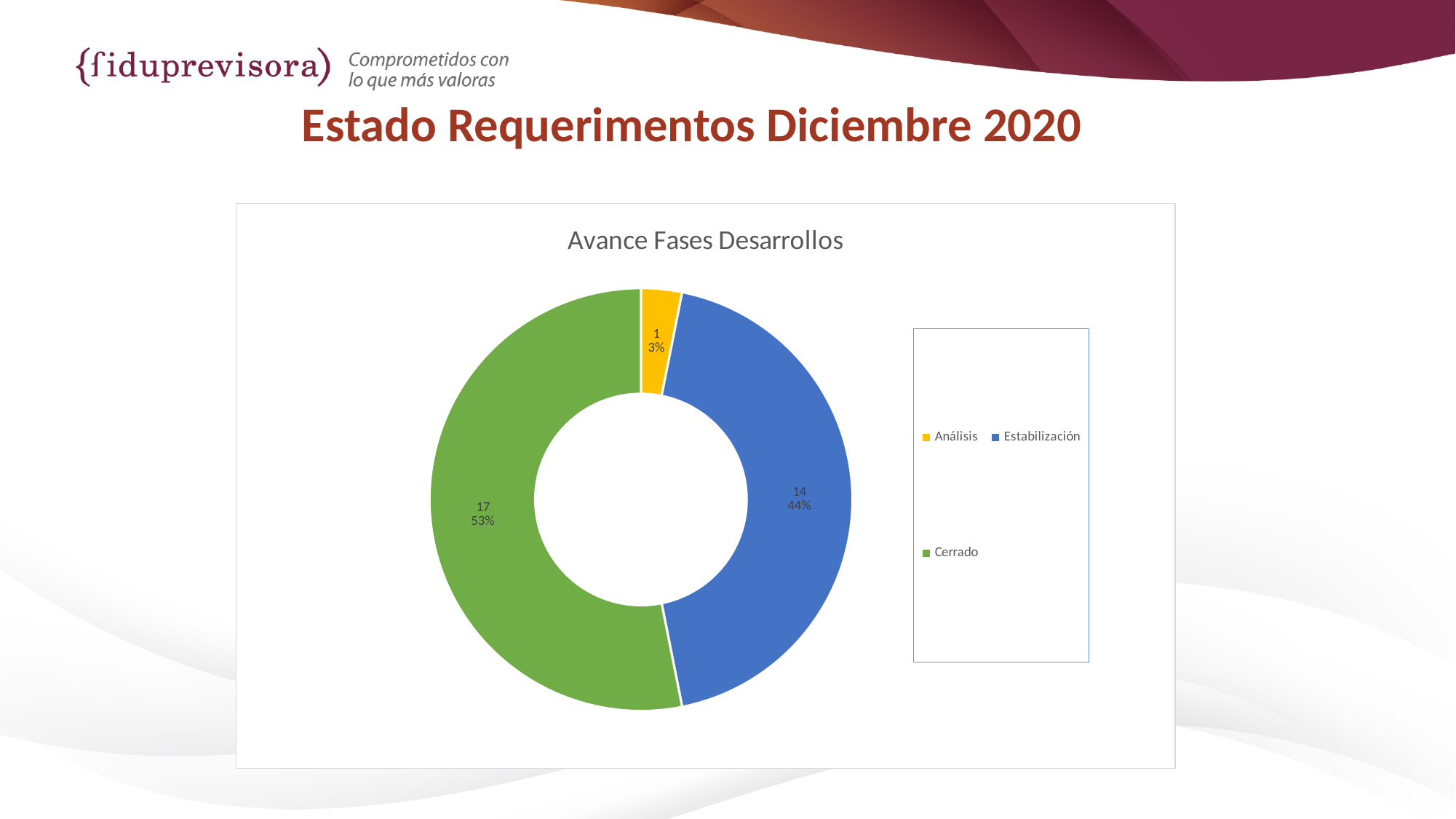
How many categories does the chart show? 3 What is the count for Cerrado? 17 What is the difference between the counts for Cerrado and Estabilización? 3 What share of the chart does Estabilización represent? 44% Which category has the largest slice? Cerrado Which category has the smallest slice? Análisis What is the title of the chart? Avance Fases Desarrollos What kind of chart is shown on the slide? Doughnut (pie) chart What share of the chart does Análisis represent? 3% What is the count for Análisis? 1 What share of the chart does Cerrado represent? 53% What is the count for Estabilización? 14